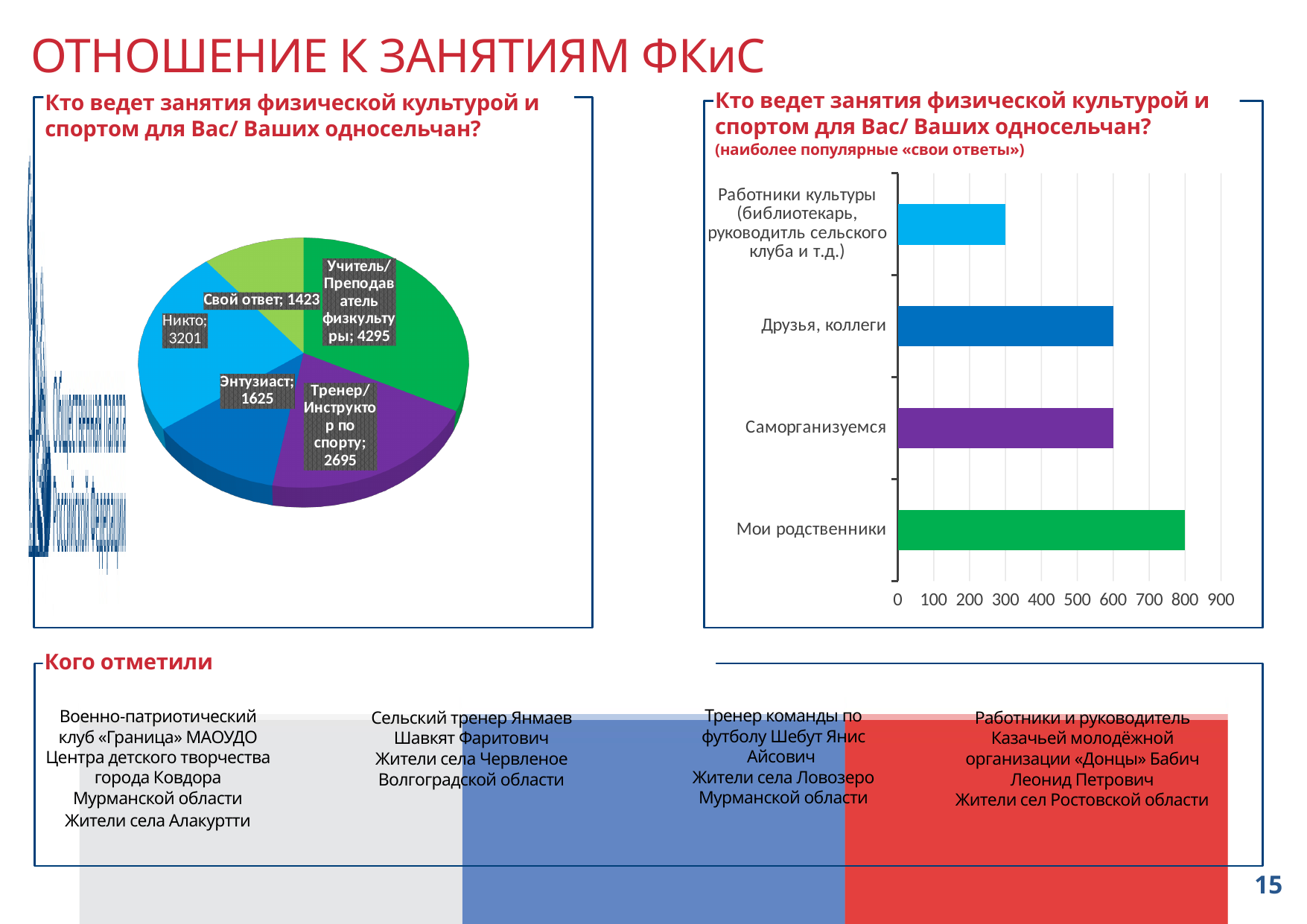
In the pie chart on the left, what is the difference between the values for Никто and Тренер/Инструктор по спорту? 506 In the pie chart on the left, what is the value for Учитель/Преподаватель физкультуры? 4295 In the bar chart on the right, which category has the highest value? Мои родственники In the pie chart on the left, which is larger: Энтузиаст or Свой ответ? Энтузиаст In the pie chart on the left, which category has the largest value? Учитель/Преподаватель физкультуры What kind of chart is the chart on the left of the slide? Pie chart In the pie chart on the left, which category has the smallest value? Свой ответ In the pie chart on the left, what is the value for Никто? 3201 In the bar chart on the right, is the value for Работники культуры greater or less than 400? less How many slices does the pie chart on the left have? 5 How many categories are shown in the bar chart on the right? 4 What kind of chart is the chart on the right of the slide? Bar chart